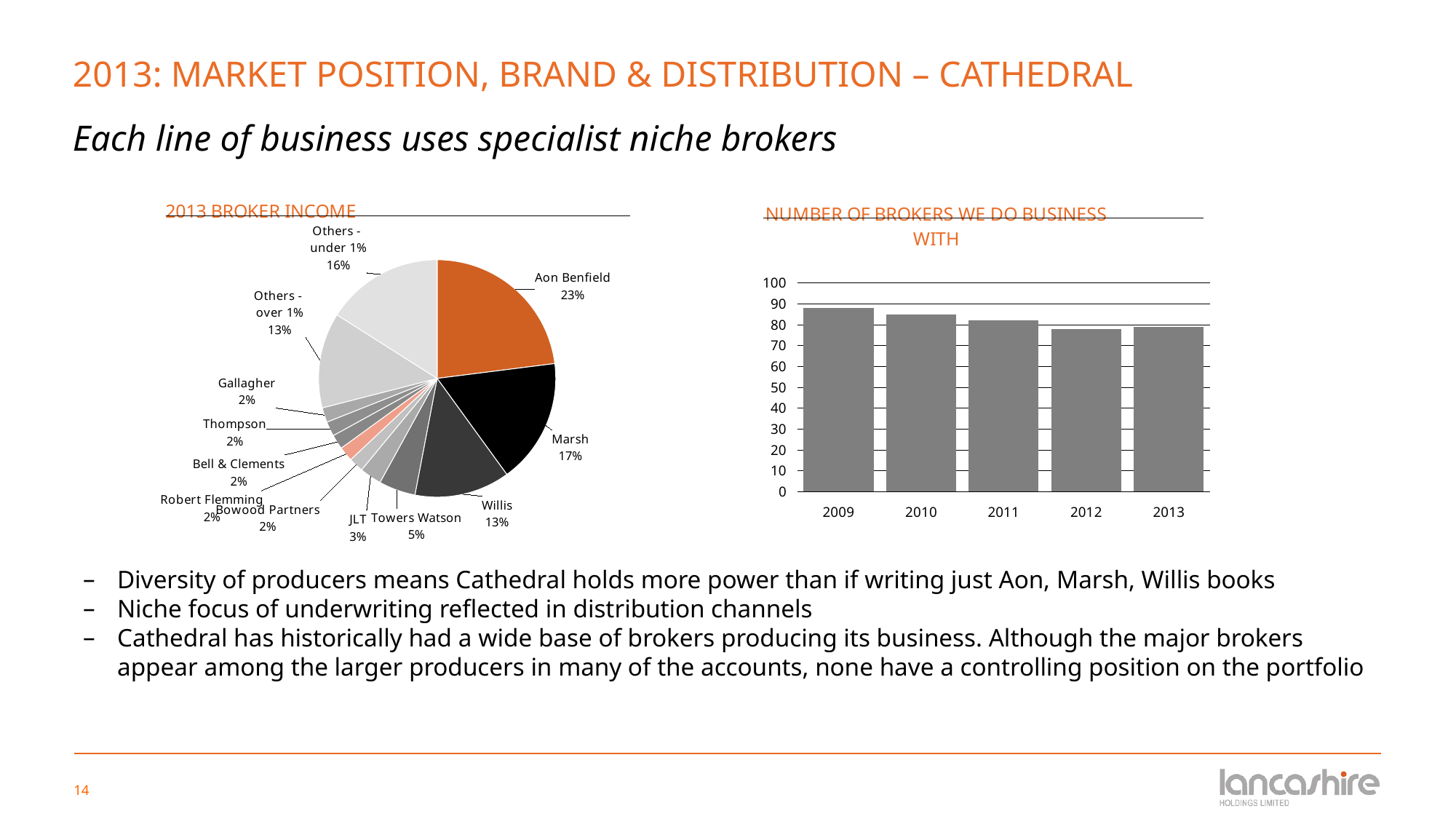
In the Number of Brokers We Do Business With chart, does the number of brokers generally rise or fall from 2009 to 2013? Fall In the Number of Brokers We Do Business With chart, is the value for 2010 greater or less than 80? greater What type of chart is the Number of Brokers We Do Business With chart? Bar chart How many slices does the 2013 Broker Income pie chart have? 12 In the Number of Brokers We Do Business With chart, is the value for 2012 greater or less than 80? less In the Number of Brokers We Do Business With chart, which year has the highest value? 2009 In the 2013 Broker Income pie chart, what percentage is attributed to Marsh? 17% In the 2013 Broker Income pie chart, what share does Towers Watson hold? 5% In the 2013 Broker Income pie chart, what is the difference in percentage points between Aon Benfield and Willis? 10 In the 2013 Broker Income pie chart, which is larger: the share for Others - under 1% or the share for Others - over 1%? Others - under 1% In the 2013 Broker Income pie chart, what share of broker income comes from Aon Benfield? 23% In the 2013 Broker Income pie chart, which broker has the largest share? Aon Benfield